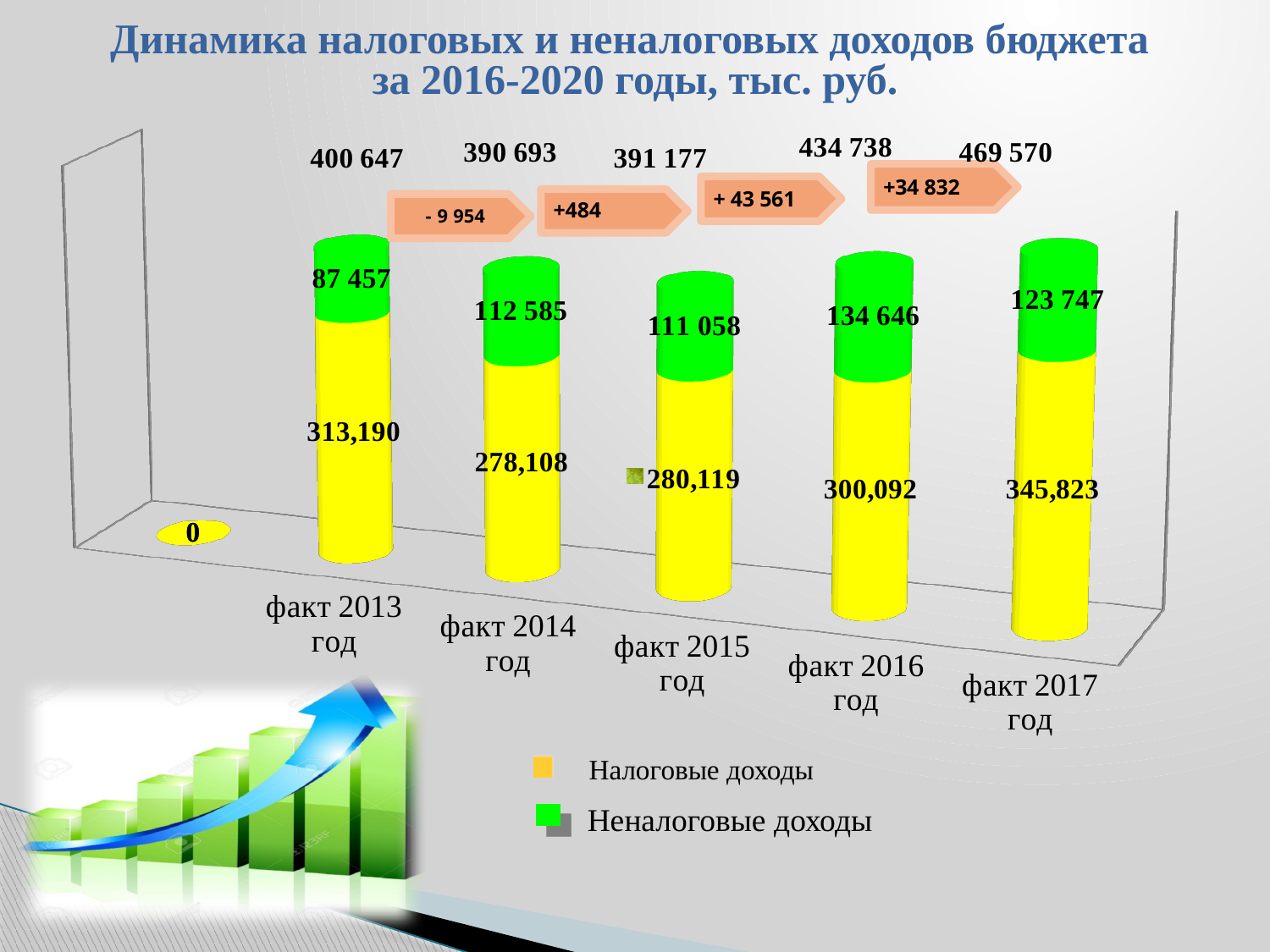
What is the value of Налоговые доходы for факт 2013 год? 313,190 Which year has the highest value of Налоговые доходы? факт 2017 год What is the value of Налоговые доходы for факт 2017 год? 345,823 What is the total shown above the bar for факт 2015 год? 391 177 What is the difference between Налоговые доходы for факт 2017 год and факт 2016 год? 45,731 What type of chart is shown on the slide? Stacked bar chart Which year has the lowest value of Неналоговые доходы? факт 2013 год How many series does the legend list? 2 What is the value of Неналоговые доходы for факт 2016 год? 134 646 Which is larger: Неналоговые доходы for факт 2014 год or for факт 2015 год? факт 2014 год Which year has the lowest value of Налоговые доходы? факт 2014 год How many year categories are shown on the chart? 5